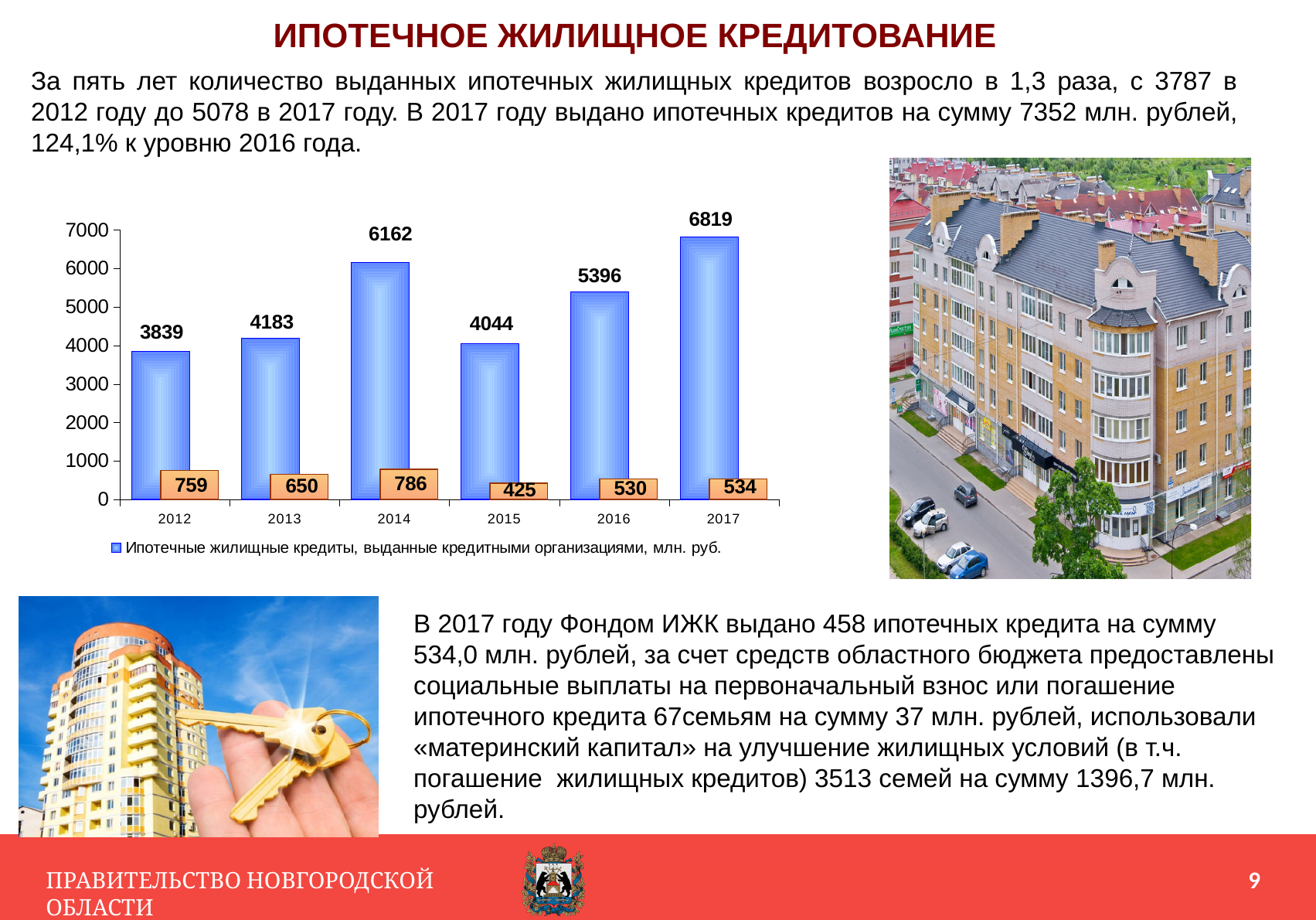
What is the difference between the blue series values for 2017 and 2016? 1423 In which year is the blue series highest? 2017 In which year is the orange bar highest? 2014 What is the value of the blue series for 2012? 3839 What kind of chart is shown on the slide? bar chart Is the blue bar for 2016 greater or less than 5000? greater How many years are shown on the x axis of the chart? 6 How many series does the chart legend list? 1 Which year has the larger blue bar, 2014 or 2015? 2014 In which year is the blue series lowest? 2012 What is the value shown on the orange bar for 2015? 425 What is the value of the blue series (ипотечные жилищные кредиты, выданные кредитными организациями) for 2017? 6819